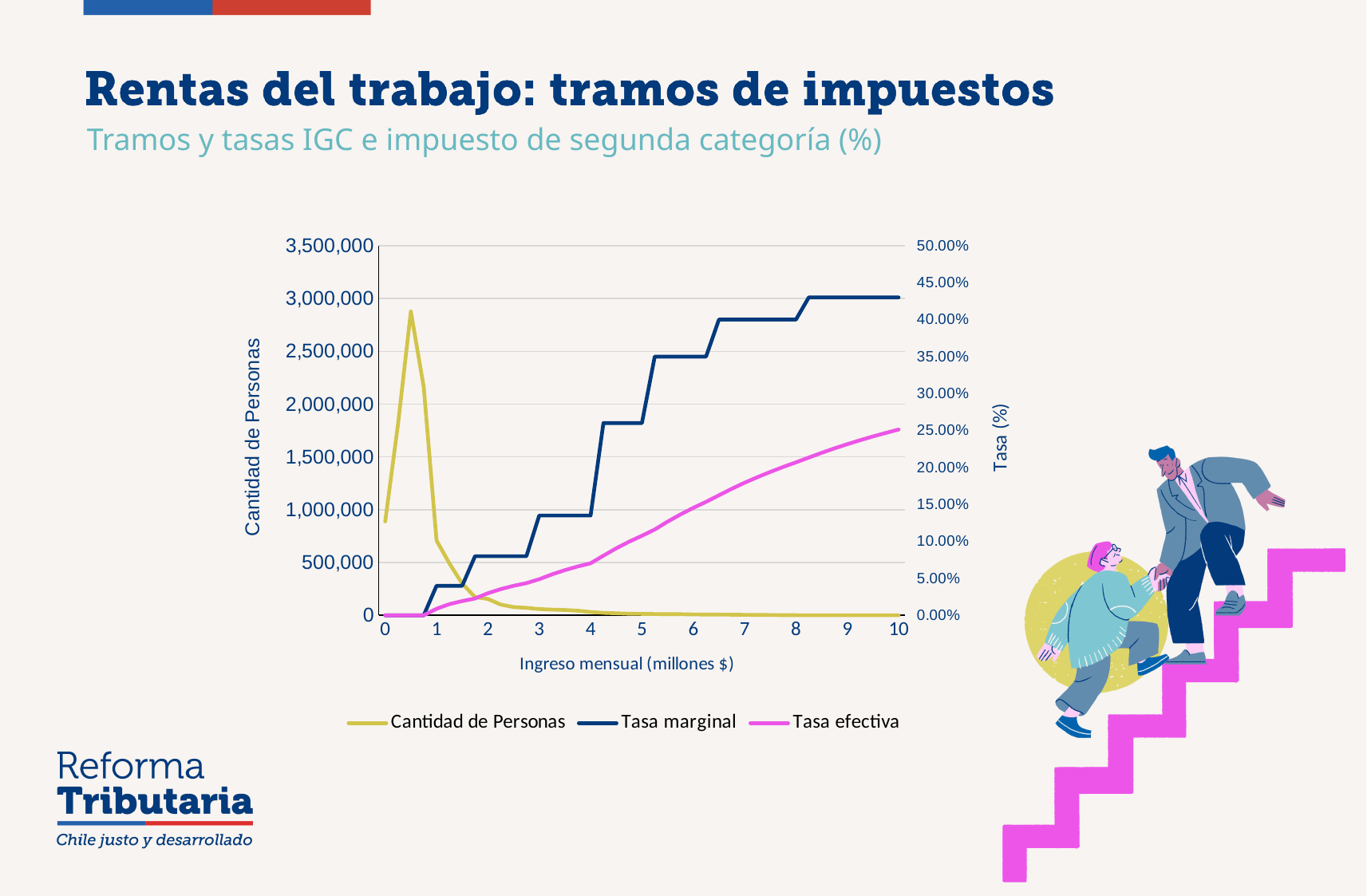
Which series is drawn in pink in the chart? Tasa efectiva What kind of chart is shown on the slide? line chart After its peak, does Cantidad de Personas rise or fall as monthly income increases? falls Is the peak value of Cantidad de Personas greater or less than 2,500,000? greater Is the Tasa marginal at a monthly income of 3 million $ greater or less than 15.00%? less Is the Tasa efectiva at a monthly income of 4 million $ greater or less than 10.00%? less Does the Tasa marginal rise or fall as monthly income increases along the x axis? rises What is the Tasa marginal at a monthly income of 7 million $? 40.00% At a monthly income of 10 million $, which is larger: Tasa marginal or Tasa efectiva? Tasa marginal What is the title of the x axis of the chart? Ingreso mensual (millones $) How many series does the chart legend list? 3